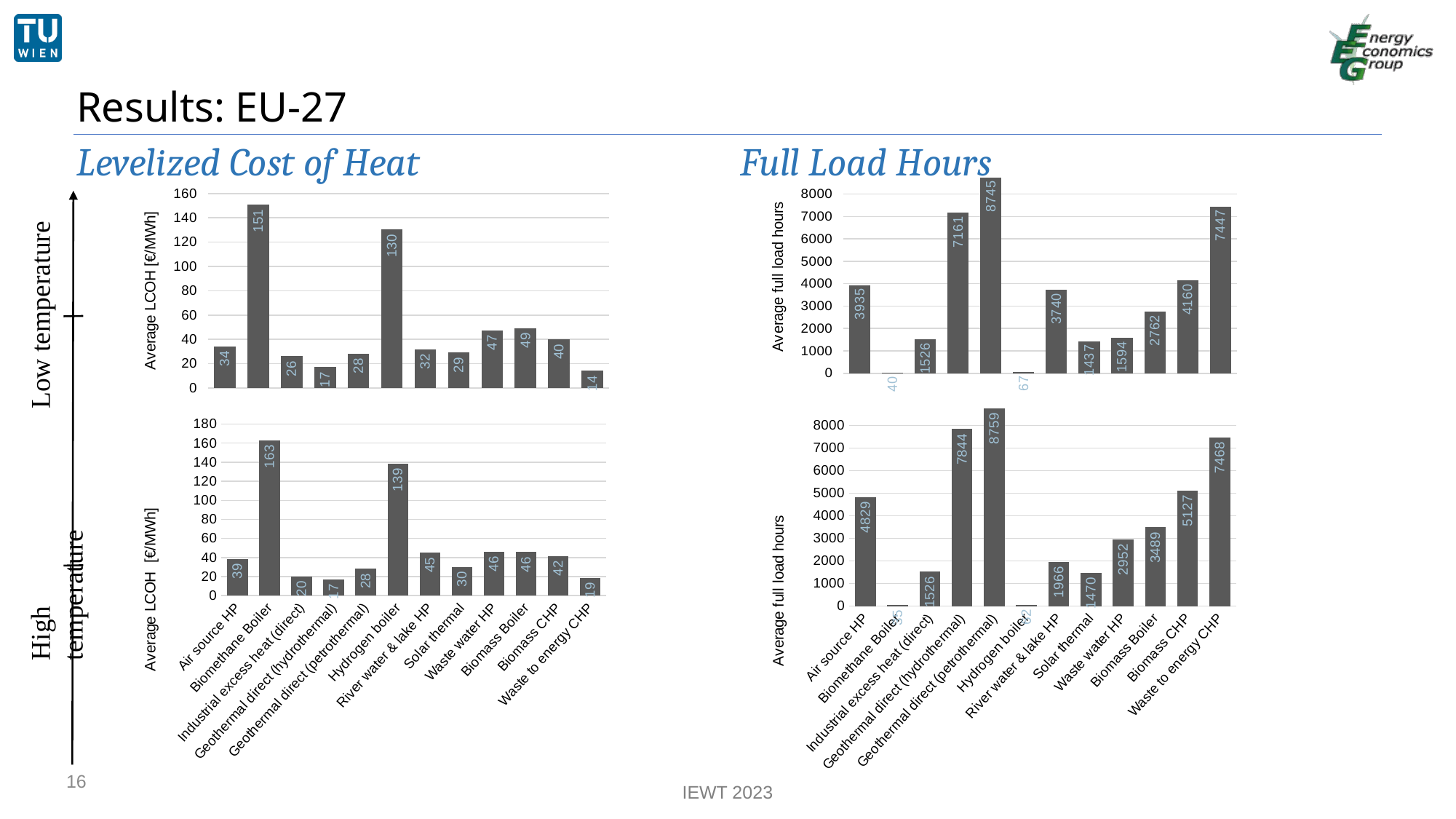
In the low temperature Full Load Hours chart (top right), which technology has the highest average full load hours? Geothermal direct (petrothermal) In the high temperature Levelized Cost of Heat chart (bottom left), what is the difference in average LCOH between Biomethane Boiler and Hydrogen boiler? 24 In the low temperature Levelized Cost of Heat chart (top left), which technology has the lowest average LCOH? Waste to energy CHP In the high temperature Full Load Hours chart (bottom right), which has more average full load hours: Waste water HP or Biomass Boiler? Biomass Boiler In the high temperature Levelized Cost of Heat chart (bottom left), what is the average LCOH for Hydrogen boiler? 139 In the high temperature Full Load Hours chart (bottom right), is the value for Geothermal direct (hydrothermal) greater or less than 7000? greater What type of chart is used for the Full Load Hours charts on the right? Bar chart How many technologies are shown on the x axis of the high temperature Levelized Cost of Heat chart (bottom left)? 12 In the low temperature Levelized Cost of Heat chart (top left), what is the average LCOH for Biomethane Boiler? 151 In the high temperature Full Load Hours chart (bottom right), what is the average full load hours for Biomass CHP? 5127 In the low temperature Full Load Hours chart (top right), what is the average full load hours for Air source HP? 3935 What is the y-axis label of the low temperature Levelized Cost of Heat chart (top left)? Average LCOH [€/MWh]